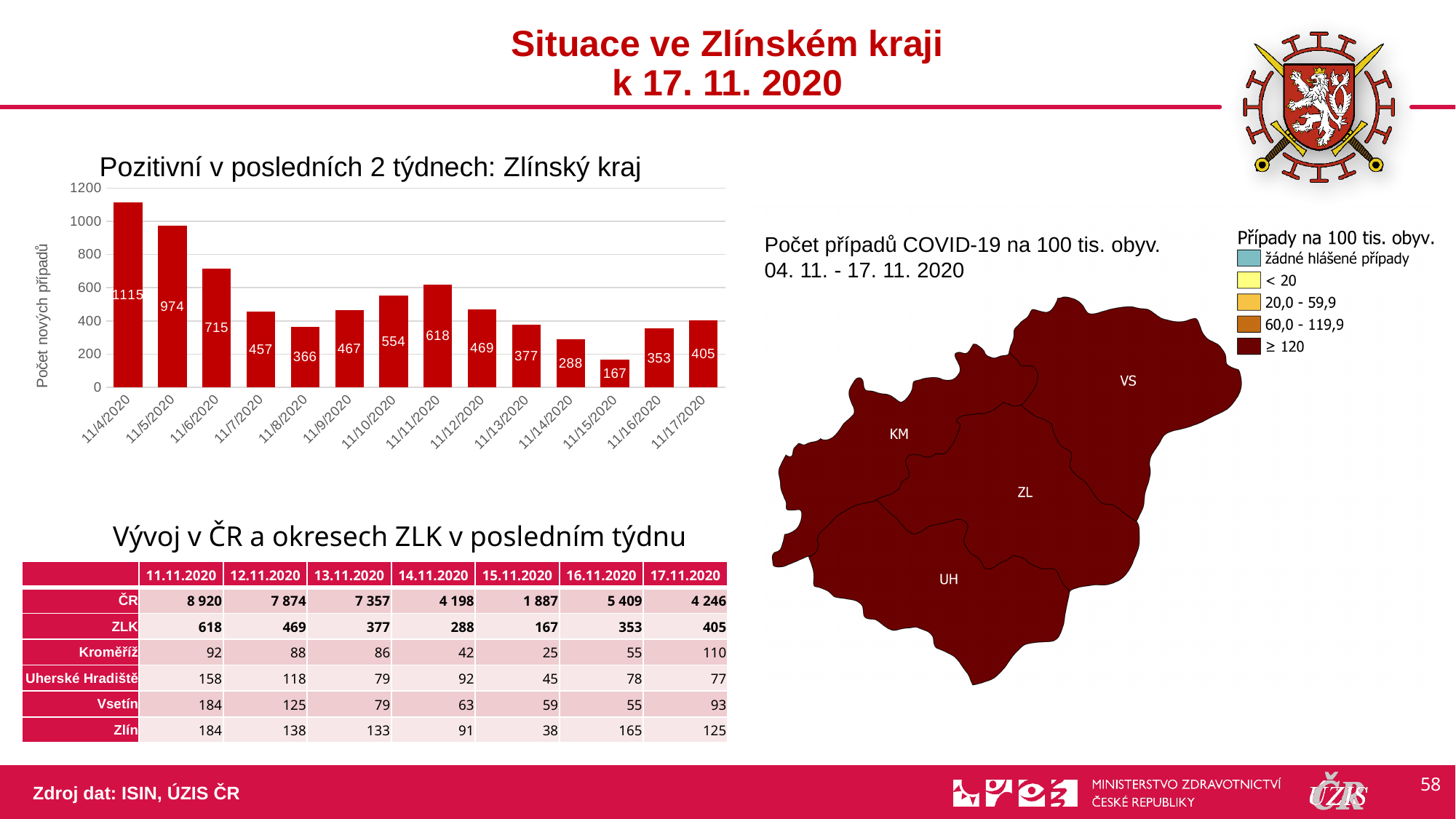
What is the value for 11/15/2020 in the bar chart? 167 What is the difference between the values for 11/17/2020 and 11/16/2020 in the bar chart? 52 Is the value for 11/6/2020 in the bar chart greater or less than 600? greater How many dates are shown in the bar chart? 14 What is the value for 11/4/2020 in the bar chart? 1115 What kind of chart is used to show the positive cases in the last 2 weeks? bar chart Which is larger in the bar chart, the value for 11/10/2020 or the value for 11/12/2020? 11/10/2020 Which date has the highest value in the bar chart? 11/4/2020 Which date has the lowest value in the bar chart? 11/15/2020 What is the title of the bar chart? Pozitivní v posledních 2 týdnech: Zlínský kraj What is the difference between the values for 11/4/2020 and 11/5/2020 in the bar chart? 141 What is the value for 11/11/2020 in the bar chart? 618